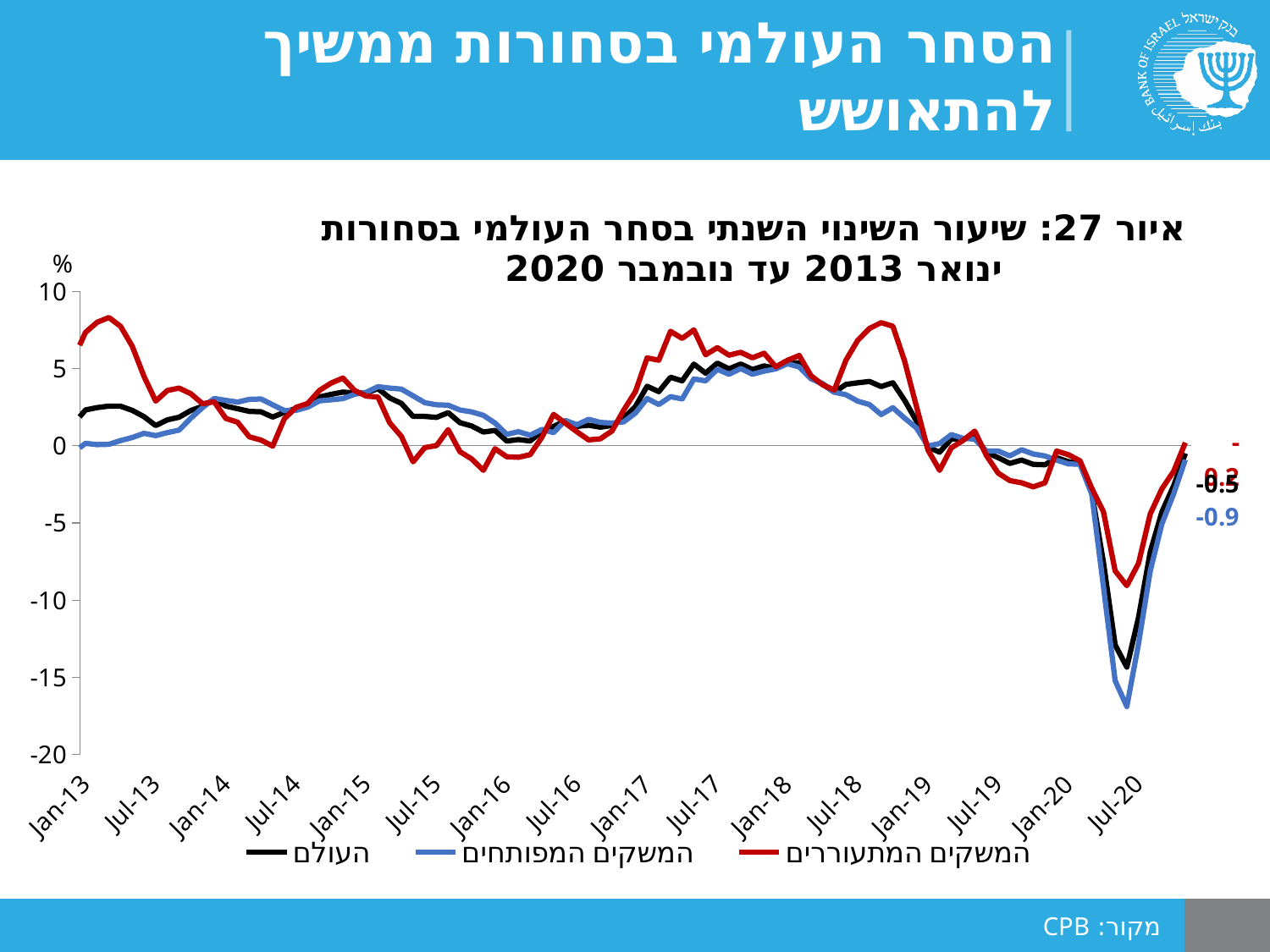
Is the lowest point of the המשקים המתעוררים (red) line in 2020 greater or less than -5? less What is the last data label shown for the המשקים המפותחים (blue) series? -0.9 After the trough around Jul-20, do the lines rise or fall toward the end of the series? rise What unit is shown on the y axis? % Is the peak of the המשקים המתעוררים (red) line in early 2013 greater or less than 5? greater Which series reaches the lowest value during 2020? המשקים המפותחים Is the lowest point of the העולם (black) line in 2020 greater or less than -10? less How many series does the legend list? 3 What kind of chart is shown on the slide? line chart Which series is drawn in red? המשקים המתעוררים At Jan-13, which series has the higher value: המשקים המתעוררים or המשקים המפותחים? המשקים המתעוררים